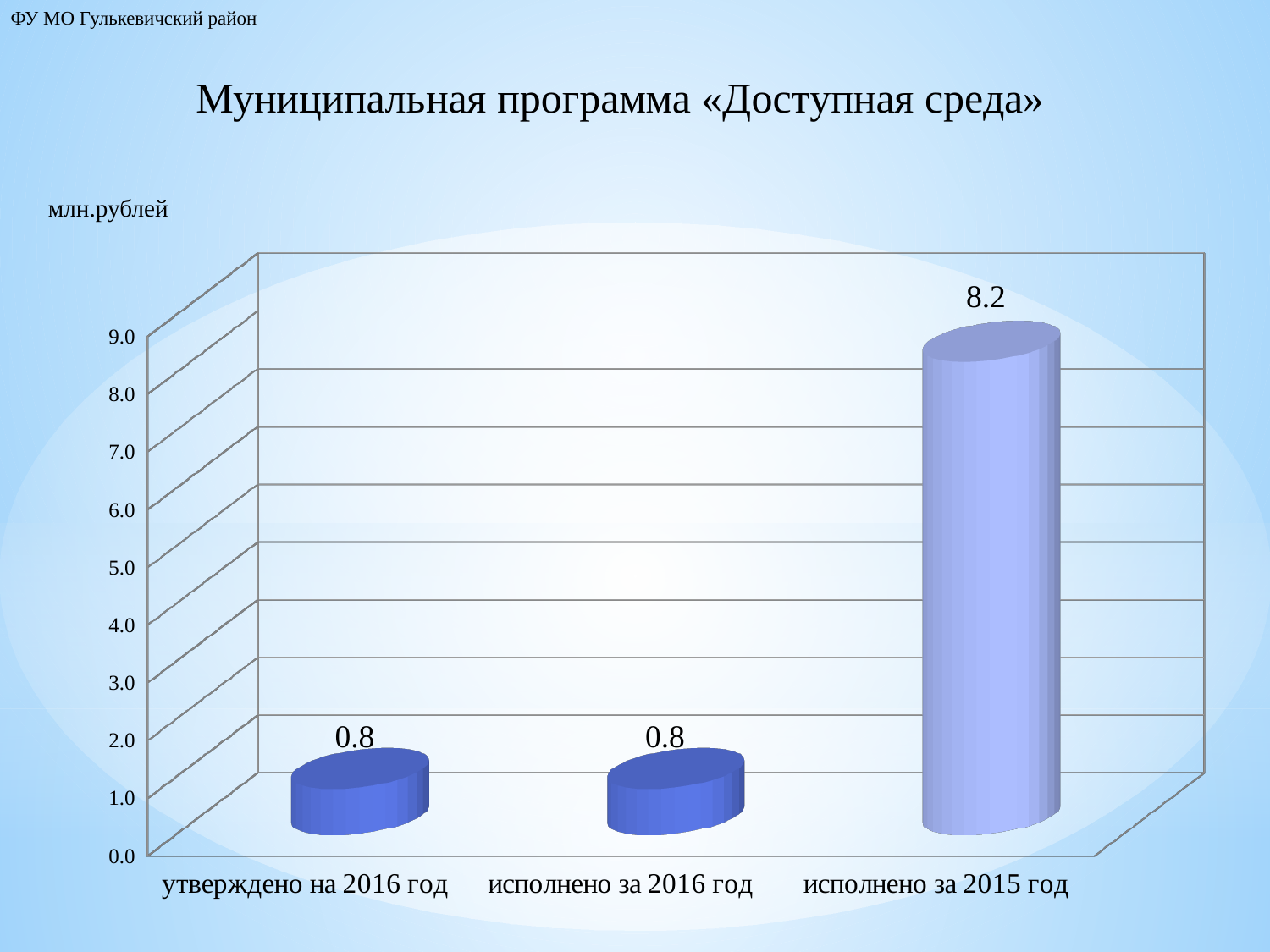
What kind of chart is shown on the slide? bar chart What is the value for «исполнено за 2015 год»? 8.2 What is the value for «утверждено на 2016 год»? 0.8 What is the difference between the value for «исполнено за 2015 год» and the value for «исполнено за 2016 год»? 7.4 Is the value for «исполнено за 2015 год» greater or less than 5.0? greater How many categories are shown on the chart? 3 Is the value for «утверждено на 2016 год» greater or less than 2.0? less What is the title of the slide? Муниципальная программа «Доступная среда» Which is larger: the value for «исполнено за 2015 год» or the value for «утверждено на 2016 год»? исполнено за 2015 год Which category has the highest value? исполнено за 2015 год What unit is indicated for the values on the chart? млн.рублей What is the value for «исполнено за 2016 год»? 0.8